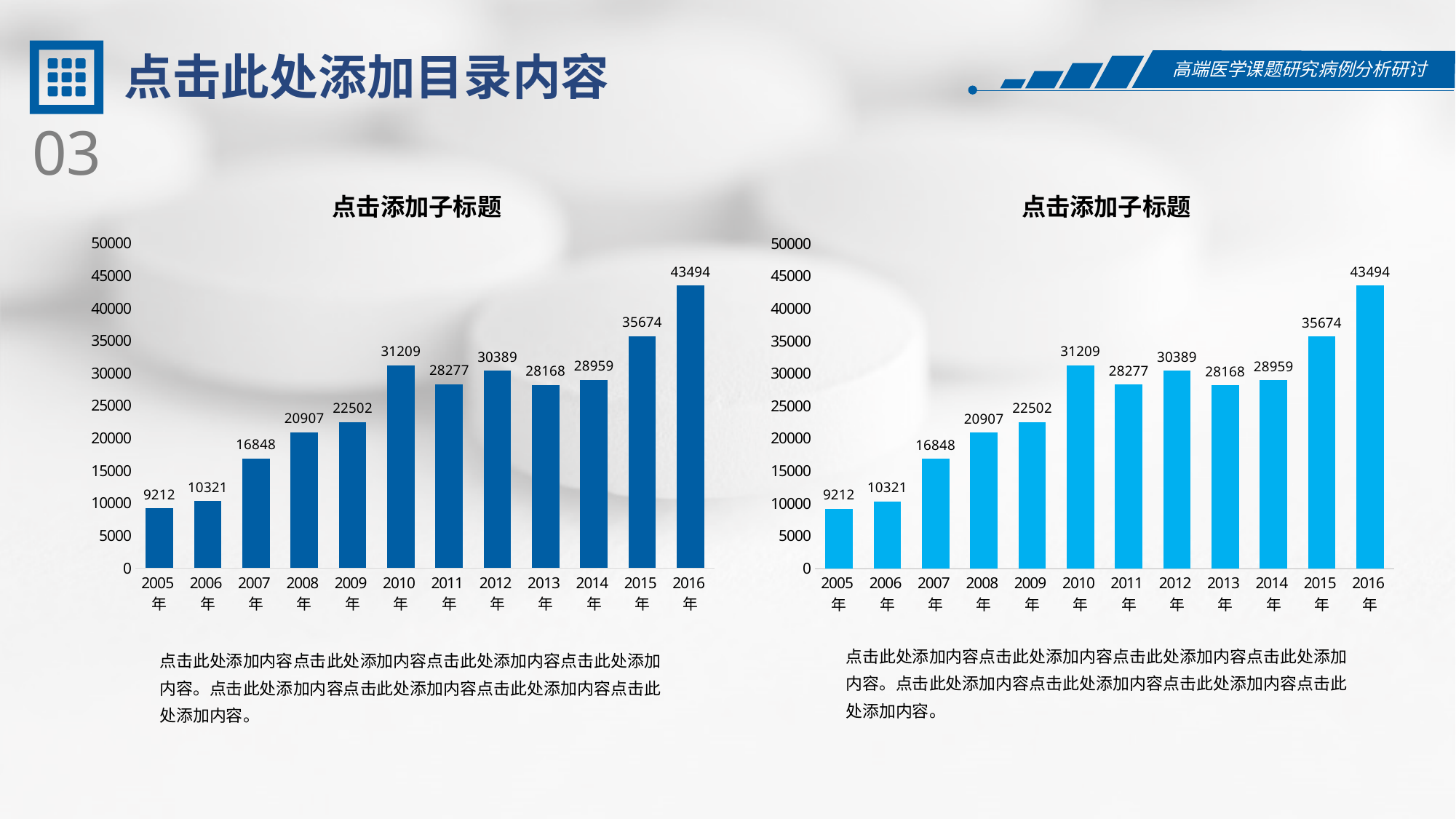
In the right chart, which year has the lowest value? 2005年 In the left chart, what is the difference between the values for 2016年 and 2015年? 7820 In the right chart, what is the difference between the values for 2009年 and 2008年? 1595 In the left chart, which year has the highest value? 2016年 What is the title of the right chart? 点击添加子标题 How many years are shown on the x axis of the left chart? 12 In the left chart, which is larger, the value for 2010年 or the value for 2012年? 2010年 In the right chart, what is the value for 2013年? 28168 What kind of chart is the right chart? bar chart In the left chart, what is the value for 2010年? 31209 In the left chart, do the values generally rise or fall from 2005年 to 2016年? rise In the right chart, is the value for 2007年 greater or less than 20000? less